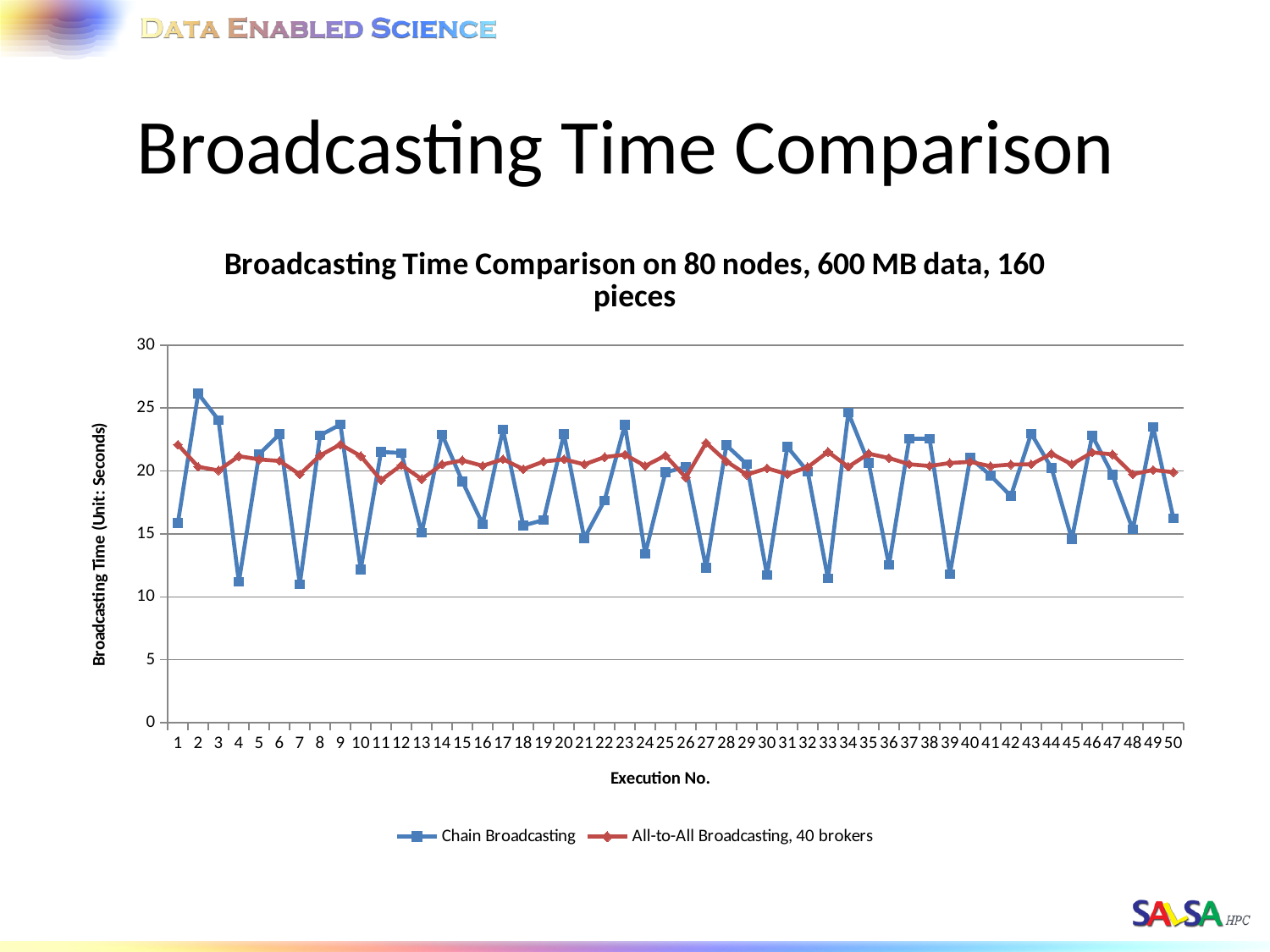
Is the All-to-All Broadcasting, 40 brokers value at execution 1 greater or less than 20? greater What is the title of the chart? Broadcasting Time Comparison on 80 nodes, 600 MB data, 160 pieces At execution 4, which series has the higher value, Chain Broadcasting or All-to-All Broadcasting, 40 brokers? All-to-All Broadcasting, 40 brokers Is the Chain Broadcasting value at execution 7 greater or less than 15? less How many execution numbers are plotted along the x axis? 50 At which execution number does Chain Broadcasting reach its highest value? 2 At execution 2, which series has the higher value, Chain Broadcasting or All-to-All Broadcasting, 40 brokers? Chain Broadcasting Is the Chain Broadcasting value at execution 2 greater or less than 25? greater How many series does the legend list? 2 What is the label of the y axis? Broadcasting Time (Unit: Seconds) What kind of chart is shown on the slide? Line chart